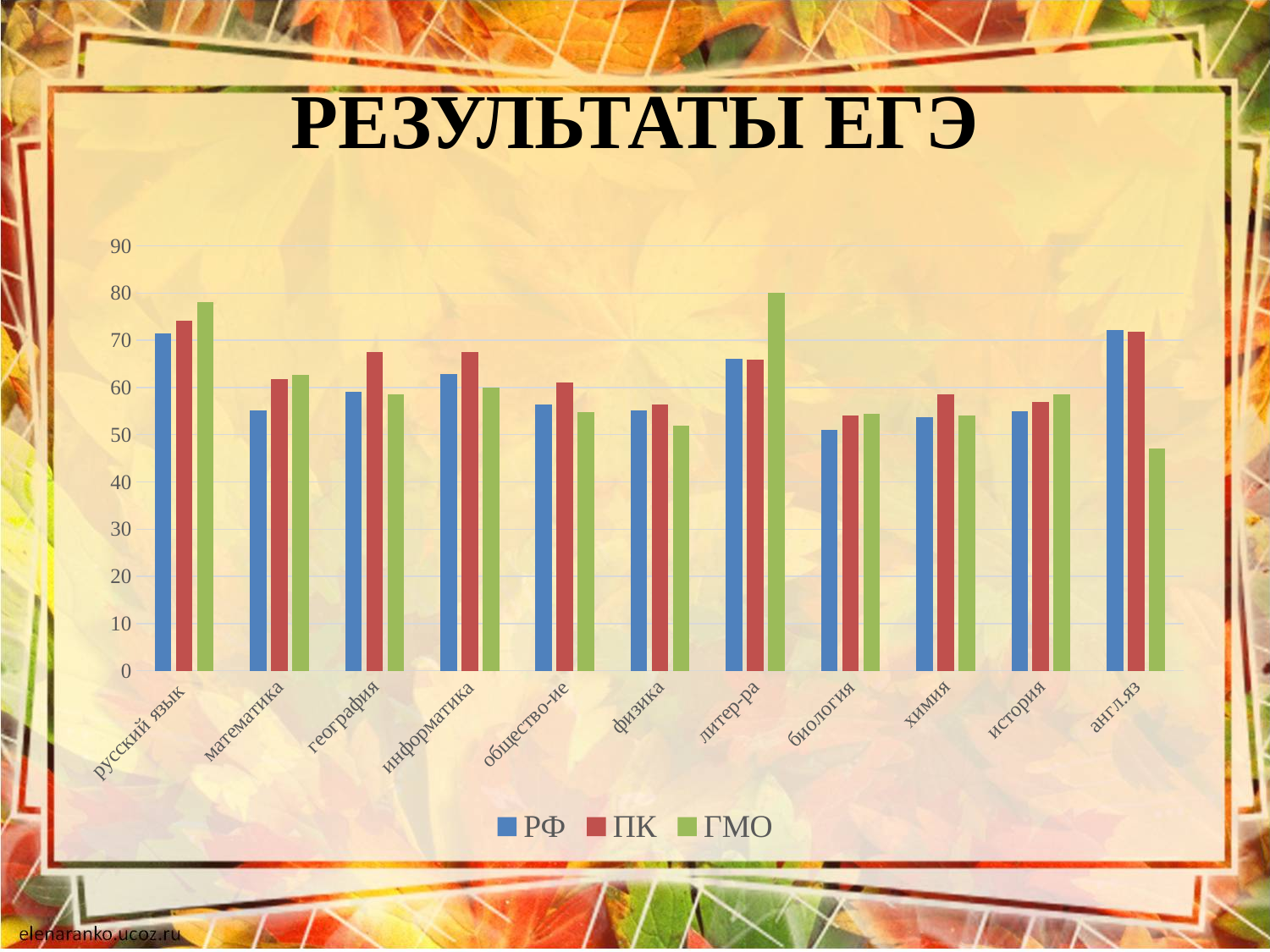
For англ.яз, which is larger: the РФ value or the ГМО value? РФ For which subject is the ГМО value the lowest? англ.яз Is the ГМО value for литер-ра greater or less than 70? greater For география, which is larger: the РФ value or the ПК value? ПК What kind of chart is shown on the slide? bar chart Is the ГМО value for англ.яз greater or less than 50? less How many subject categories are shown on the x axis? 11 What is the title of the chart? РЕЗУЛЬТАТЫ ЕГЭ Is the ПК value for география greater or less than 60? greater How many series does the legend list? 3 Which series is shown in green in the legend? ГМО For which subject is the ГМО value the highest? литер-ра